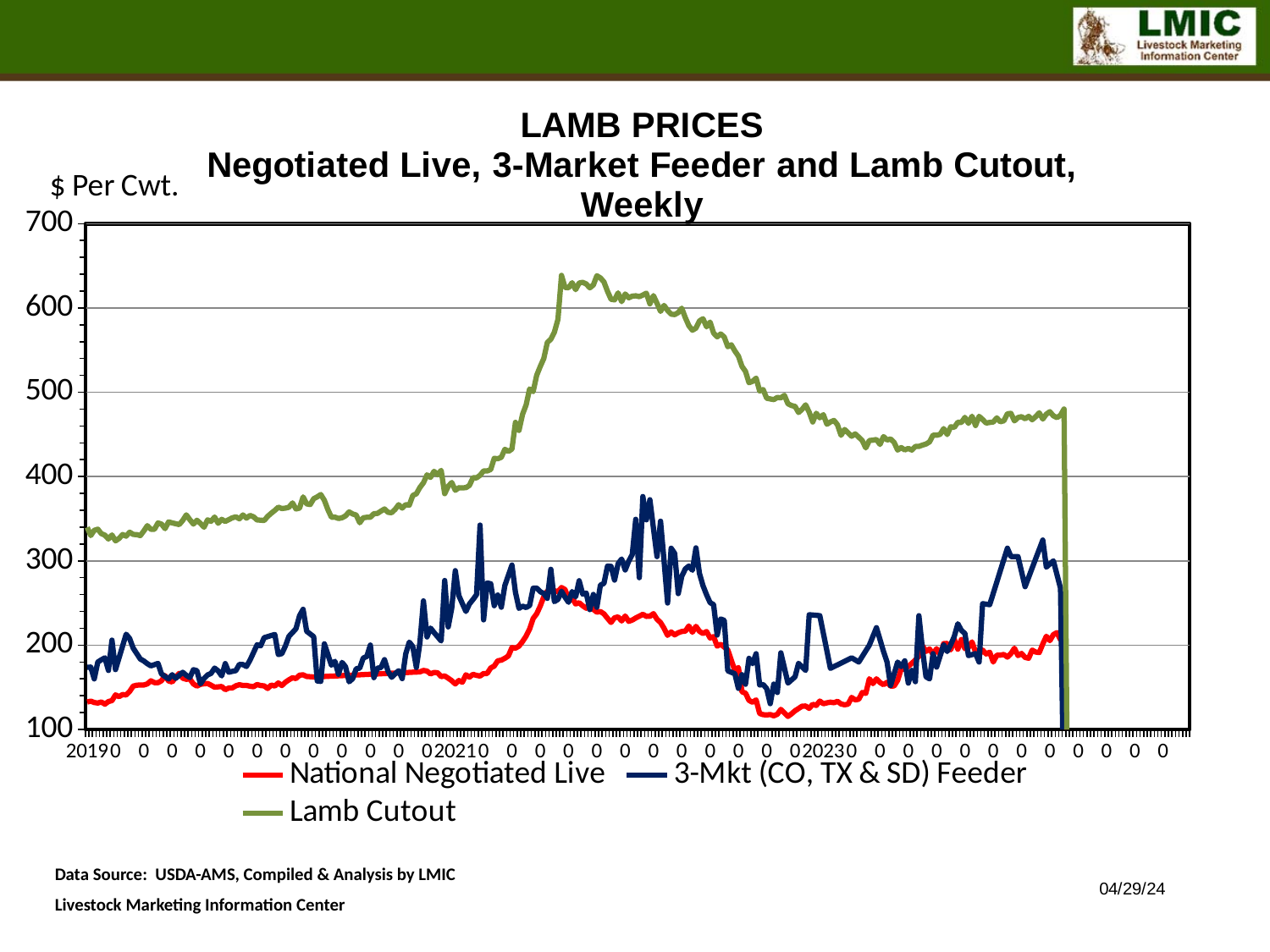
How many series does the legend list? 3 Which series is higher throughout the chart, Lamb Cutout or National Negotiated Live? Lamb Cutout Which series is plotted in green? Lamb Cutout What unit is shown on the vertical axis? $ Per Cwt. What is the highest value shown on the vertical axis? 700 Is the lowest value of the Lamb Cutout series greater or less than 300? greater What kind of chart is shown on the slide? line chart Is the peak value of the 3-Mkt (CO, TX & SD) Feeder series greater or less than 300? greater Does the Lamb Cutout series rise or fall from the start of 2019 to its peak in 2021? rise Is the lowest value of the National Negotiated Live series greater or less than 200? less Which series reaches the highest value on the chart? Lamb Cutout